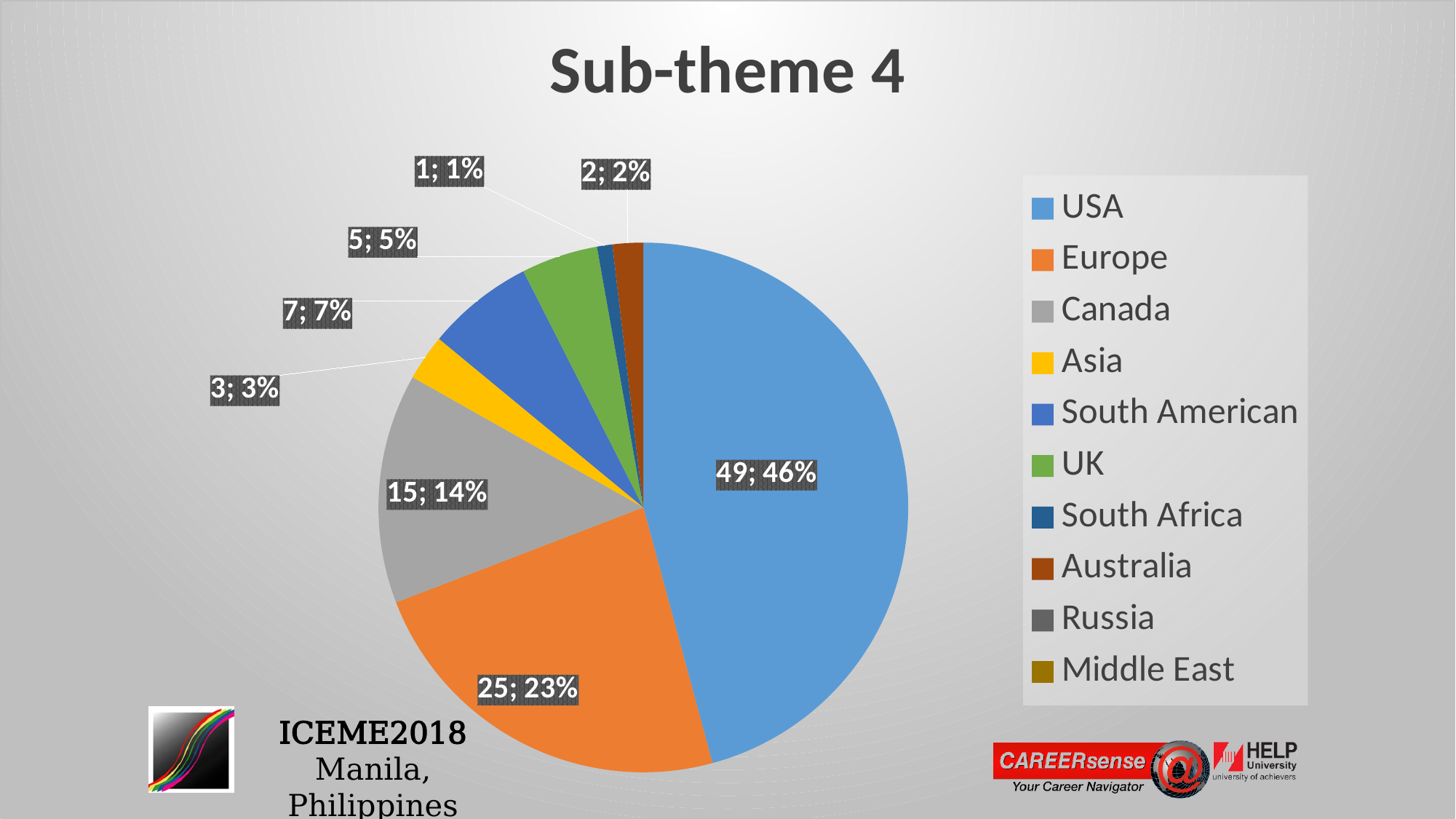
What is the difference between the counts for USA and Europe? 24 What count is shown for the USA slice? 49 What count is shown for Europe? 25 Which category has the largest slice of the pie? USA What kind of chart is shown on the slide? pie chart What percentage share of the pie does Canada have? 14% What percentage share does Asia have? 3% What is the title of the chart? Sub-theme 4 What percentage share of the pie does USA have? 46% What count is shown for the UK slice? 5 How many entries does the legend list? 10 Which has the larger slice, Canada or South American? Canada